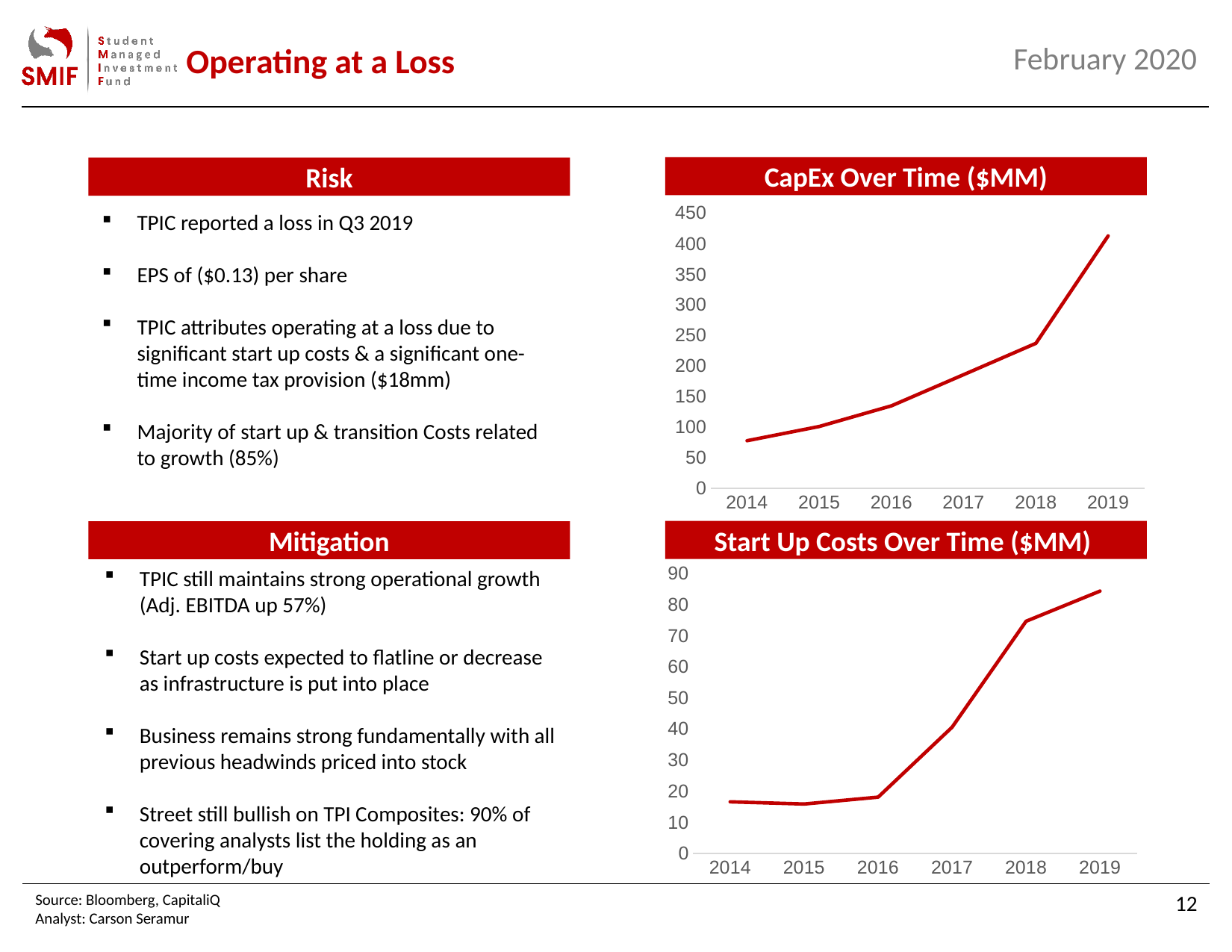
In the 'CapEx Over Time ($MM)' chart, is the value for 2014 greater or less than 100? less In the 'Start Up Costs Over Time ($MM)' chart, which year has the highest start up costs? 2019 What kind of chart is the 'CapEx Over Time ($MM)' chart? line chart What is the title of the lower chart on the right side of the slide? Start Up Costs Over Time ($MM) In the 'CapEx Over Time ($MM)' chart, which year has the larger value, 2016 or 2017? 2017 In the 'Start Up Costs Over Time ($MM)' chart, is the value for 2018 greater or less than 60? greater In the 'CapEx Over Time ($MM)' chart, do values rise or fall from 2014 to 2019? rise How many years are plotted on the 'Start Up Costs Over Time ($MM)' chart? 6 In the 'CapEx Over Time ($MM)' chart, which year has the highest CapEx? 2019 In the 'Start Up Costs Over Time ($MM)' chart, do values rise or fall from 2016 to 2019? rise In the 'CapEx Over Time ($MM)' chart, is the value for 2019 greater or less than 350? greater In the 'CapEx Over Time ($MM)' chart, which year has the lowest CapEx? 2014